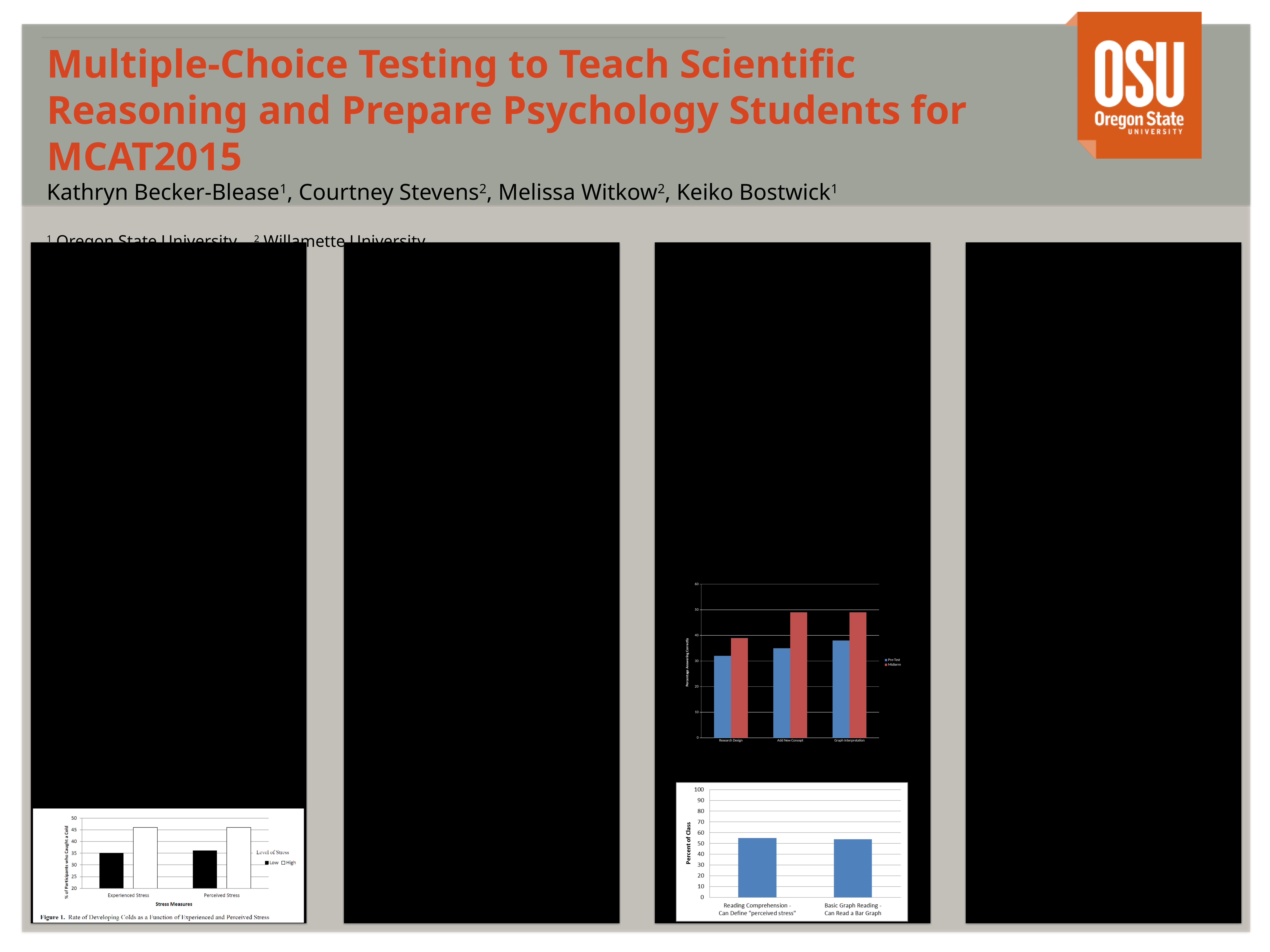
In the chart at the bottom of the left column (Figure 1), what kind of chart is shown? bar chart In the chart at the bottom of the left column (Figure 1), which series is larger for Perceived Stress, Low or High? High In the lower chart of the third column (Percent of Class), is the value for Basic Graph Reading - Can Read a Bar Graph greater or less than 70? less In the upper chart of the third column (Pre-Test vs Midterm), which series is larger for Add New Concept, Pre-Test or Midterm? Midterm In the upper chart of the third column (Pre-Test vs Midterm), how many categories are shown on the x axis? 3 In the upper chart of the third column (Pre-Test vs Midterm), is the Pre-Test value for Research Design greater or less than 40? less In the chart at the bottom of the left column (Figure 1), how many series does the legend list? 2 In the lower chart of the third column (Percent of Class), how many categories are shown? 2 In the chart at the bottom of the left column (Figure 1), is the High bar for Experienced Stress greater or less than 40? greater In the upper chart of the third column (Pre-Test vs Midterm), which category has the lowest Pre-Test value? Research Design In the upper chart of the third column (Pre-Test vs Midterm), what is the y-axis label? Percentage Answering Correctly In the chart at the bottom of the left column (Figure 1), what are the two legend entries? Low and High